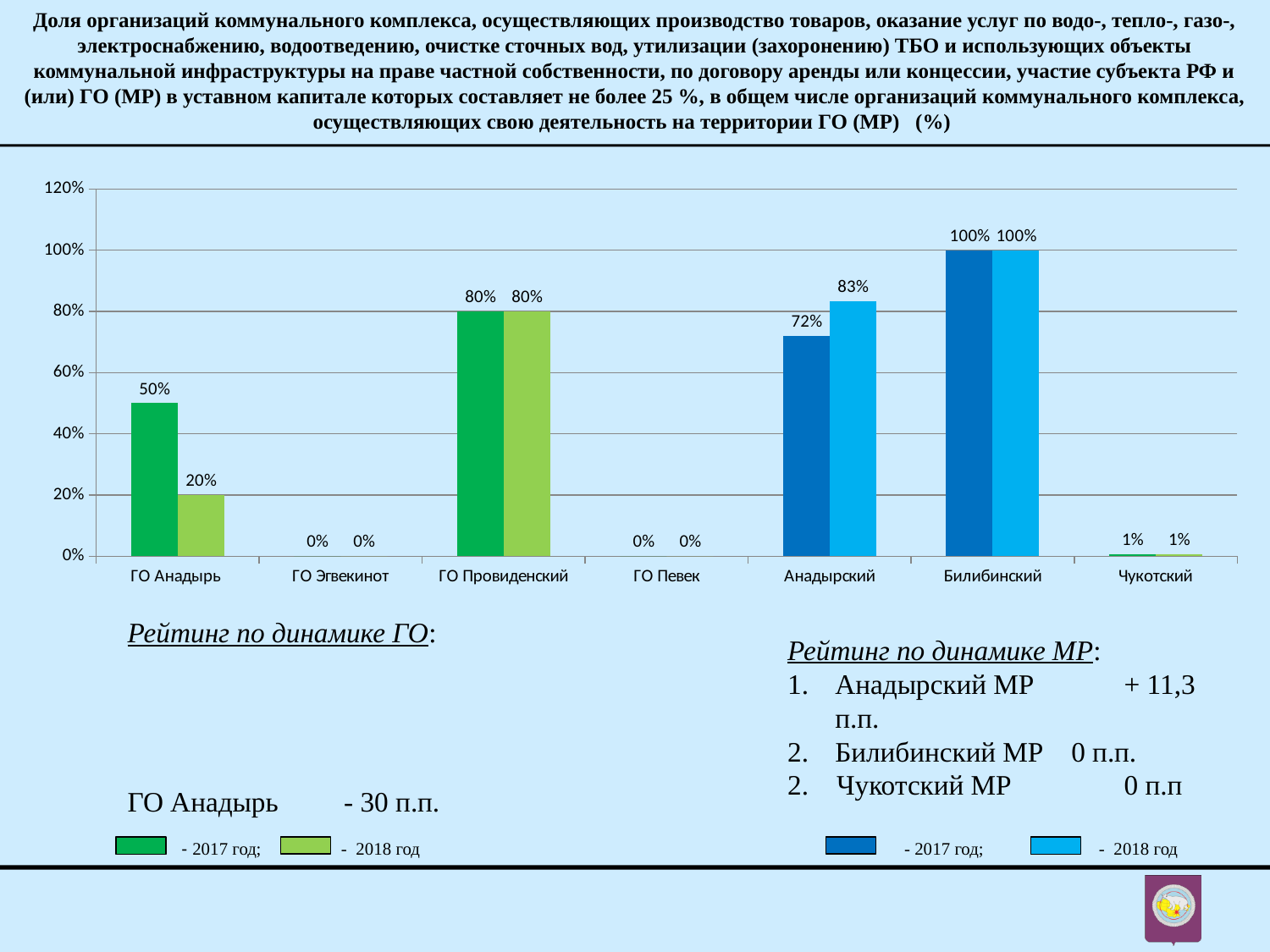
Which two categories show 0% for both 2017 and 2018? ГО Эгвекинот and ГО Певек What is the 2017 value for ГО Провиденский? 80% What is the difference between the 2018 and 2017 values for Анадырский? 11% What is the 2018 value for ГО Анадырь? 20% What is the 2017 value for ГО Анадырь? 50% What type of chart is shown on the slide? Bar chart What is the value for Чукотский in 2017? 1% What is the 2018 value for Анадырский? 83% What is the difference between the 2017 and 2018 values for ГО Анадырь? 30% How many categories are shown on the x axis of the chart? 7 Which category has the highest values in the chart? Билибинский Which is larger for Анадырский: the 2017 value or the 2018 value? 2018